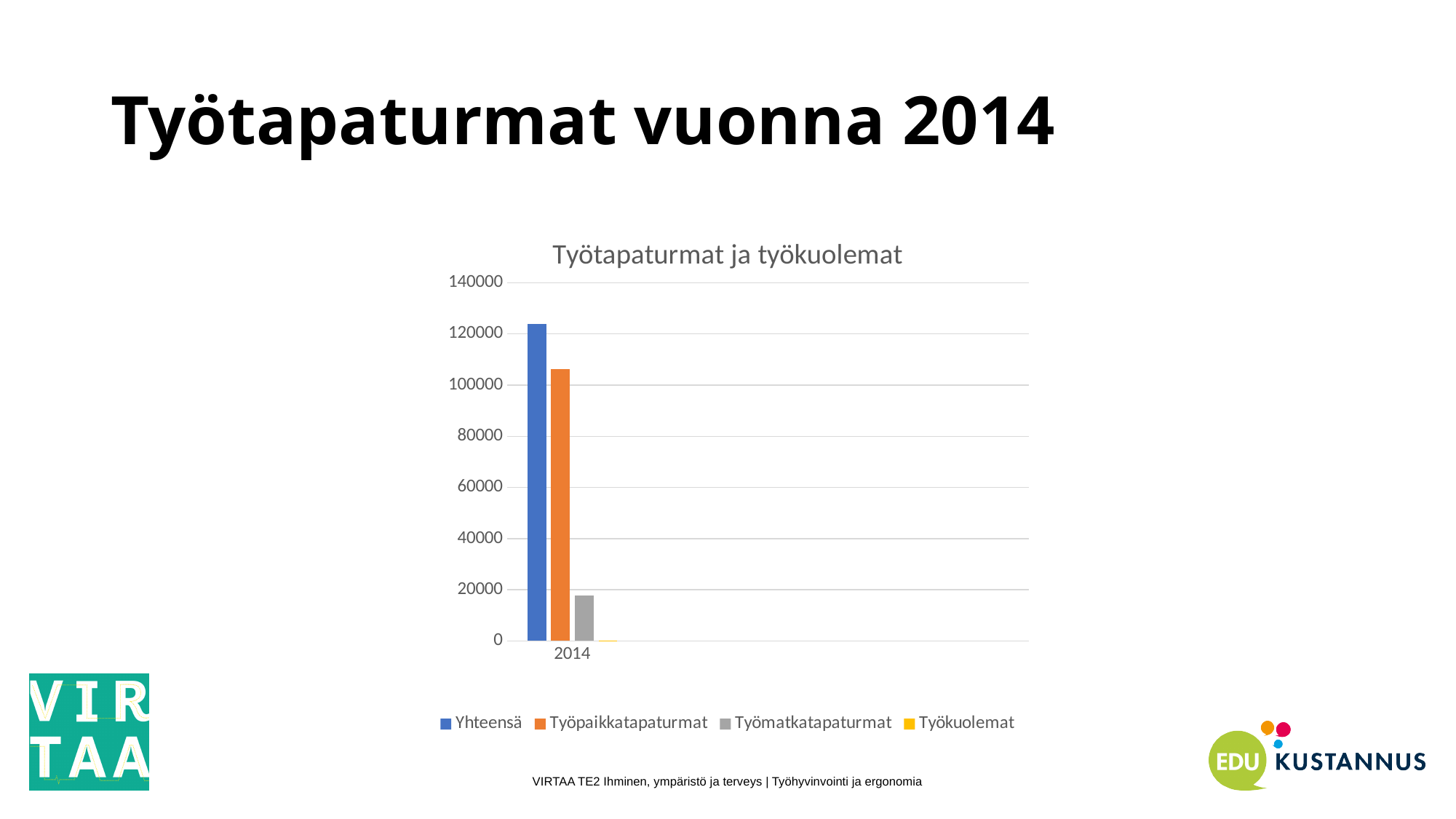
Is the value for Yhteensä greater or less than 100000? greater How many categories are shown on the x axis? 1 Is the value for Työmatkatapaturmat greater or less than 40000? less Is the value for Työkuolemat greater or less than 20000? less Which is larger, Työpaikkatapaturmat or Työmatkatapaturmat? Työpaikkatapaturmat Which series has the highest value in 2014? Yhteensä What is the title of the chart? Työtapaturmat ja työkuolemat Which colour represents the Työmatkatapaturmat series in the legend? grey How many series does the legend list? 4 Which series has the lowest value in 2014? Työkuolemat What kind of chart is shown on the slide? bar chart